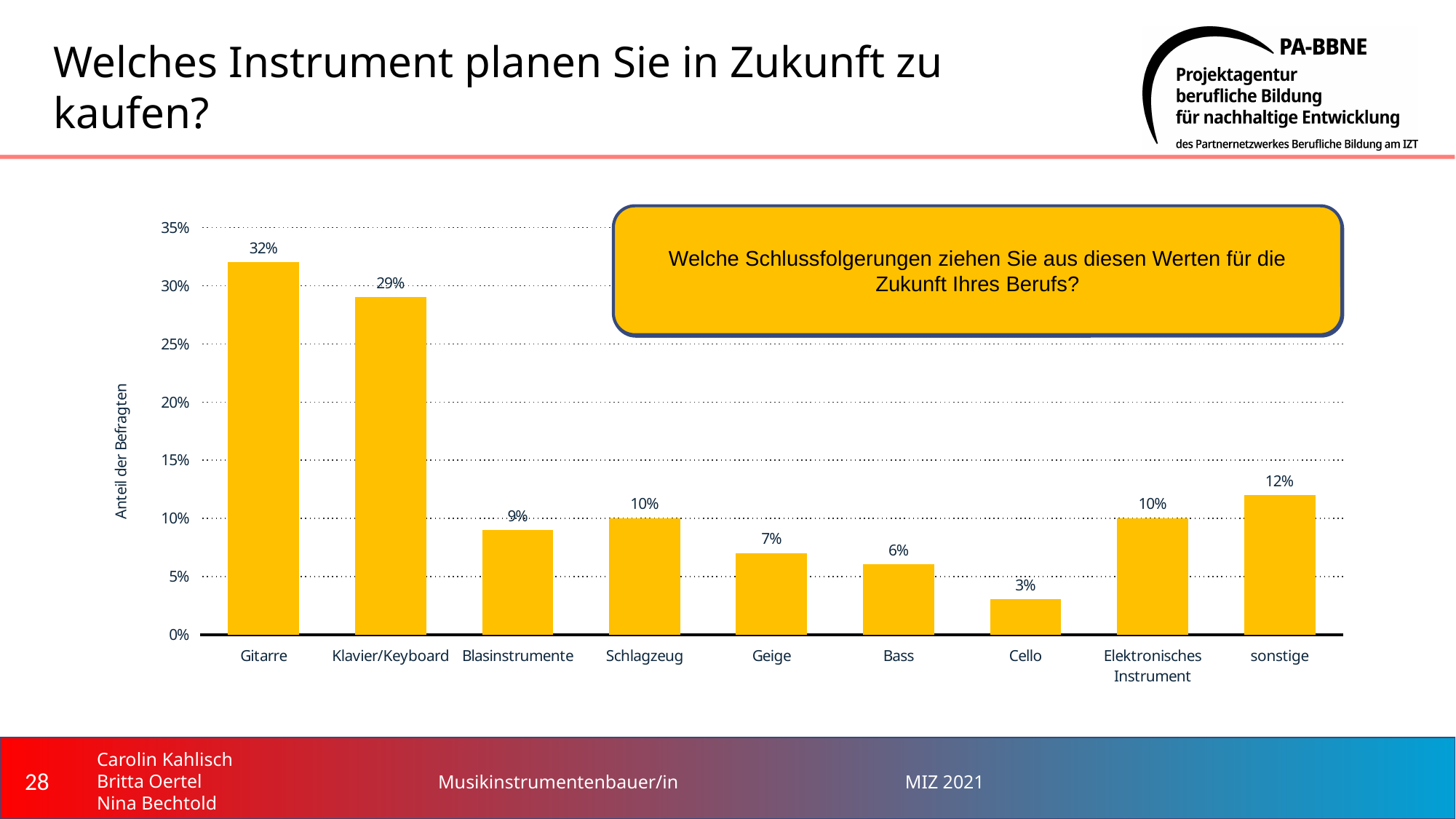
How many categories are shown on the x axis? 9 What is the value for Elektronisches Instrument? 10% What is the value for Gitarre? 32% Which is larger, the value for Geige or the value for Bass? Geige What is the difference between the values for sonstige and Bass? 6% Which category has the highest value? Gitarre What is the label of the y axis? Anteil der Befragten What kind of chart is shown on the slide? Bar chart Which category has the lowest value? Cello What is the value for Cello? 3% What is the difference between the values for Gitarre and Klavier/Keyboard? 3% What is the value for Klavier/Keyboard? 29%